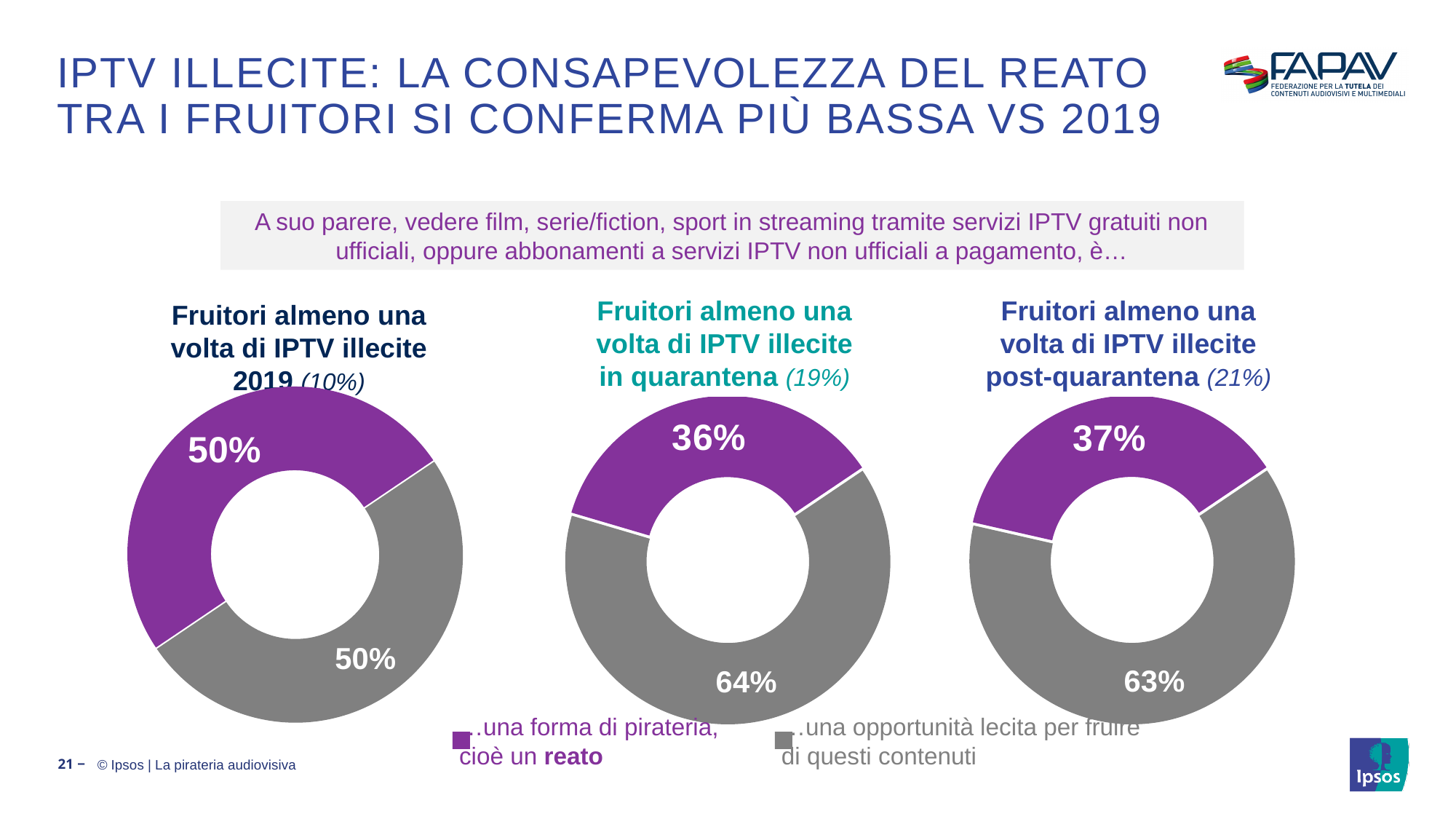
How many slices does each donut chart have? 2 Across the three charts, which group has the highest share considering illicit IPTV a crime (reato)? Fruitori 2019 (50%) What kind of chart is used on this slide? Donut (pie) chart In the 'in quarantena' chart (middle), what share of users consider illicit IPTV a lawful opportunity to enjoy this content? 64% In the 'post-quarantena' chart (right), what share of users consider illicit IPTV a lawful opportunity to enjoy this content? 63% Across the three charts, which group has the lowest share considering illicit IPTV a crime (reato)? Fruitori in quarantena (36%) In the 'in quarantena' chart (middle), what is the difference between the 'opportunità lecita' share and the 'reato' share? 28 percentage points In the 'in quarantena' chart (middle), what share of users consider illicit IPTV a form of piracy, i.e. a crime (reato)? 36% In the 'post-quarantena' chart (right), which slice is larger: 'una forma di pirateria, cioè un reato' or 'una opportunità lecita'? una opportunità lecita In the 2019 chart (left), what share of users consider illicit IPTV a form of piracy, i.e. a crime (reato)? 50% Which colour represents 'una forma di pirateria, cioè un reato' in the charts? Purple How many entries does the legend list? 2